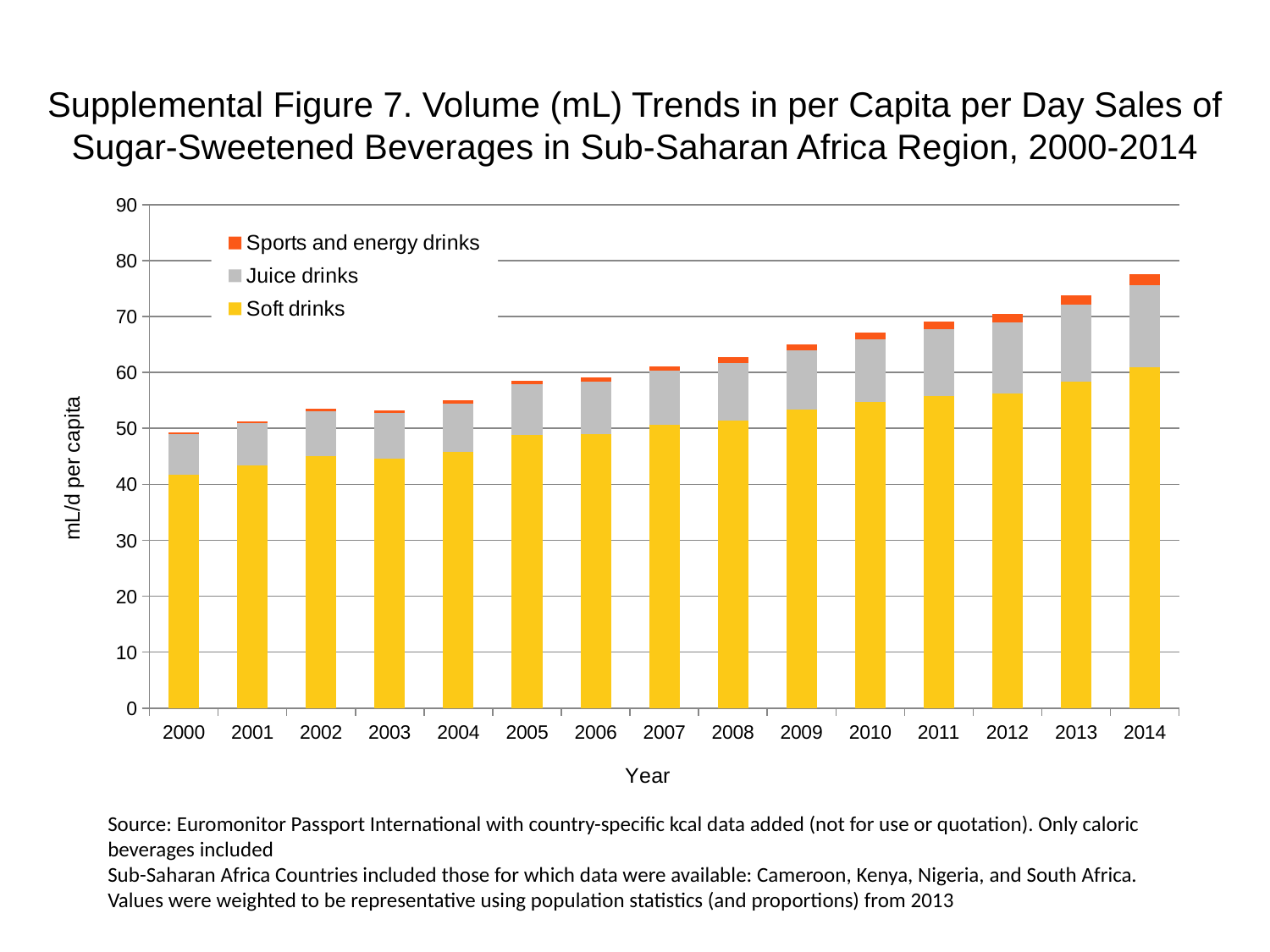
Is the Soft drinks value for 2014 greater or less than 60? greater How many years are shown along the x axis of the chart? 15 Which series is shown in orange in the chart's legend? Sports and energy drinks How many series does the chart's legend list? 3 Is the Soft drinks value for 2000 greater or less than 40? greater What kind of chart is shown on the slide? Stacked bar chart Is the total bar for 2014 greater or less than 80? less Do the total bar heights generally rise or fall from 2000 to 2014? Rise Which year has the tallest total bar in the chart? 2014 What is the label on the y axis of the chart? mL/d per capita Which is larger, the Soft drinks value for 2008 or the Soft drinks value for 2002? 2008 Which year has the shortest total bar in the chart? 2000